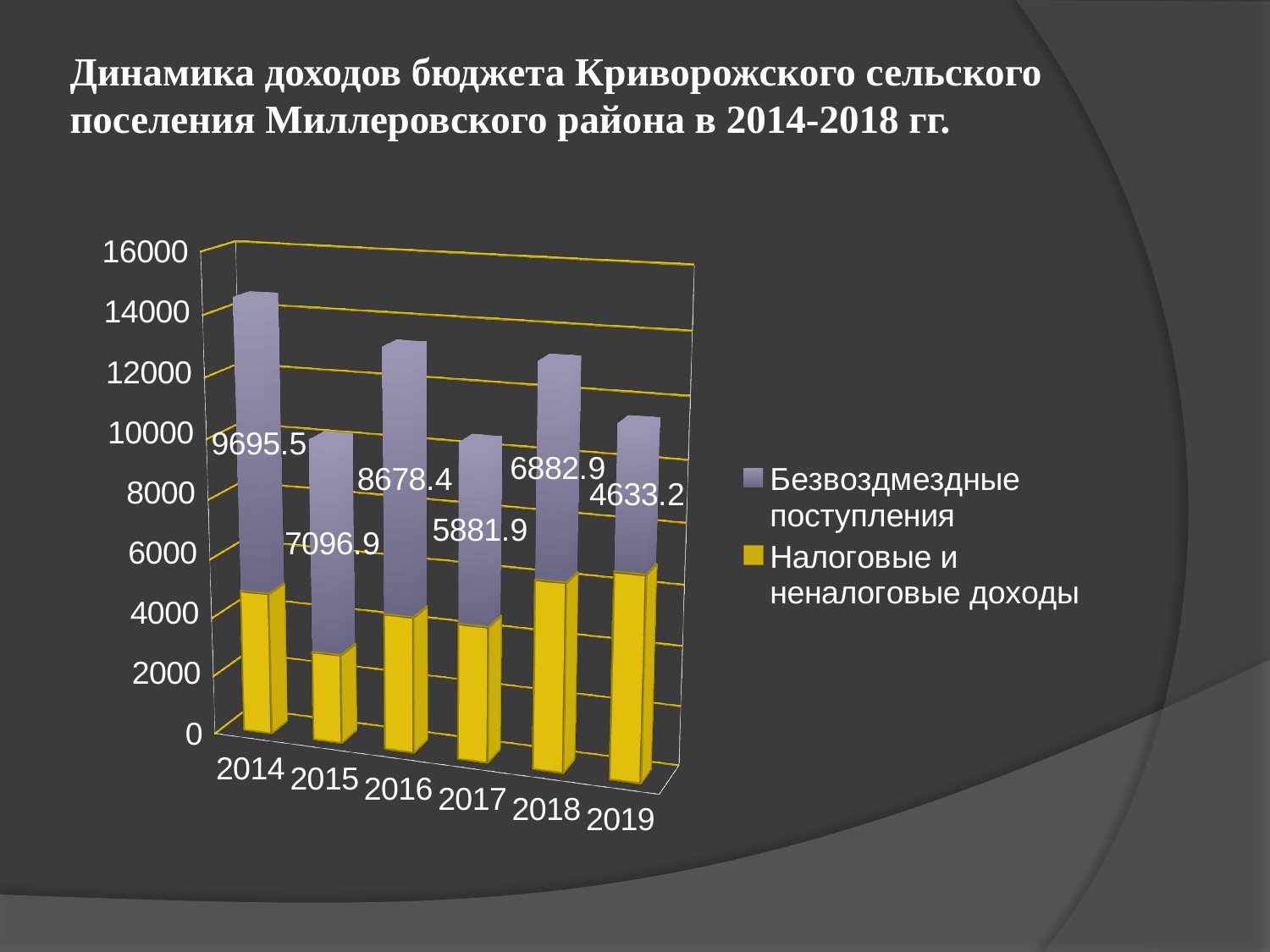
How many years are shown on the x axis of the chart? 6 What is the difference between the Безвоздмездные поступления values for 2014 and 2019? 5062.3 What is the value of Безвоздмездные поступления for 2014? 9695.5 What is the difference between the Безвоздмездные поступления values for 2016 and 2015? 1581.5 Is the value of Налоговые и неналоговые доходы for 2015 greater or less than 4000? less In which year is the value of Безвоздмездные поступления the lowest? 2019 What is the value of Безвоздмездные поступления for 2017? 5881.9 What is the value of Безвоздмездные поступления for 2019? 4633.2 In which year is the value of Безвоздмездные поступления the highest? 2014 How many series does the legend list? 2 Which year has the larger value of Безвоздмездные поступления, 2016 or 2018? 2016 What kind of chart is shown on the slide? Stacked bar chart